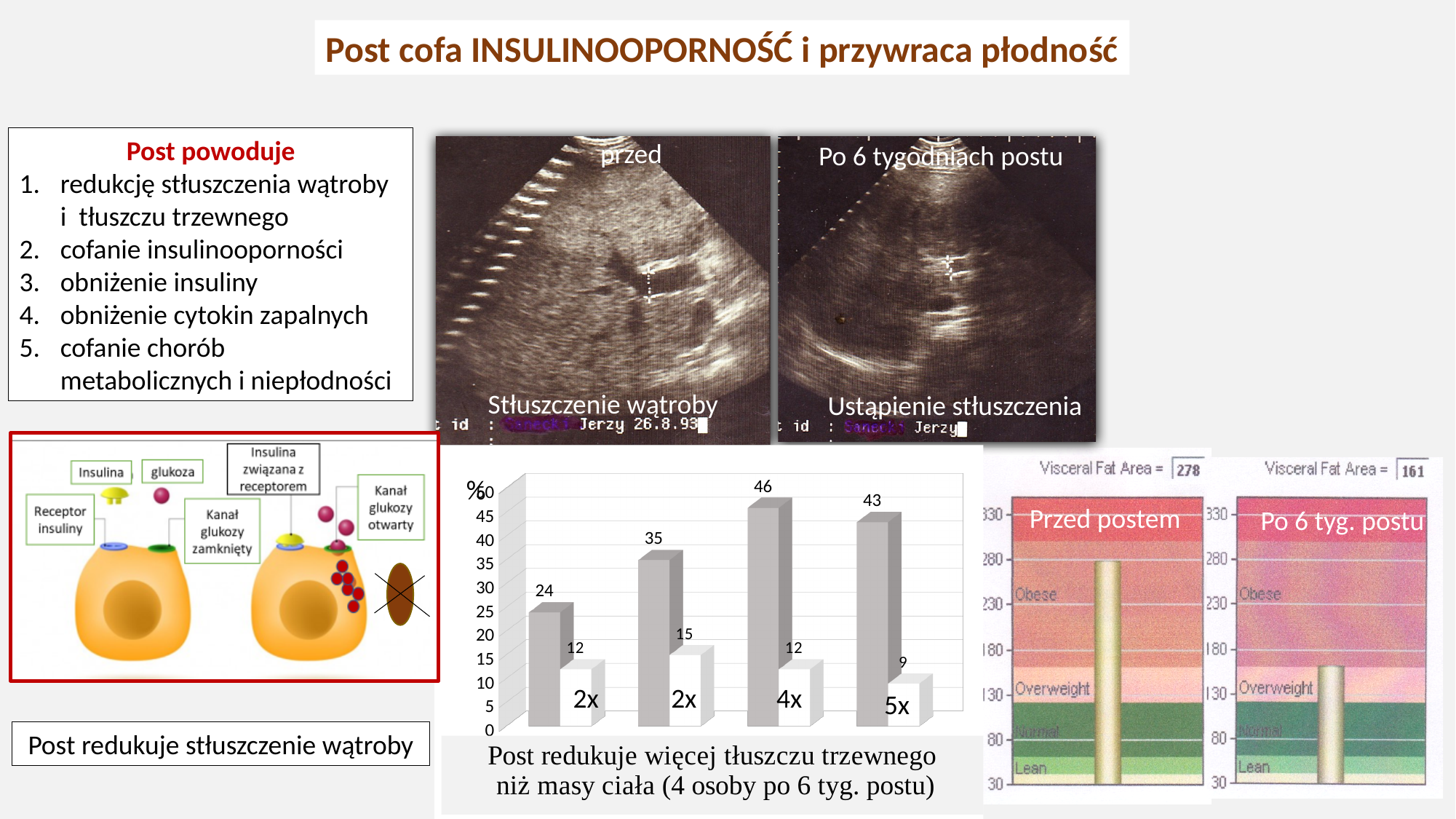
In the bar chart at the bottom centre, what is the value of the dark grey bar in the first group? 24 In the bar chart at the bottom centre, which is larger: the dark grey bar in the second group or the dark grey bar in the fourth group? the fourth group (43) In the bar chart at the bottom centre, what is the difference between the dark grey bar and the white bar in the third group? 34 What label is printed under the fourth group of bars in the bar chart at the bottom centre? 5x In the bar chart at the bottom centre, which group has the highest dark grey bar? the third group (4x), 46 In the bar chart at the bottom centre, what is the value of the white bar in the second group? 15 What kind of chart is shown at the bottom centre of the slide? bar chart In the bar chart at the bottom centre, which group has the lowest white bar? the fourth group (5x), 9 In the bar chart at the bottom centre, what is the value of the white bar in the fourth group (labelled 5x)? 9 In the bar chart at the bottom centre, what is the difference between the dark grey bar and the white bar in the first group? 12 What unit is shown on the vertical axis of the bar chart at the bottom centre? % How many groups of bars does the bar chart at the bottom centre show? 4